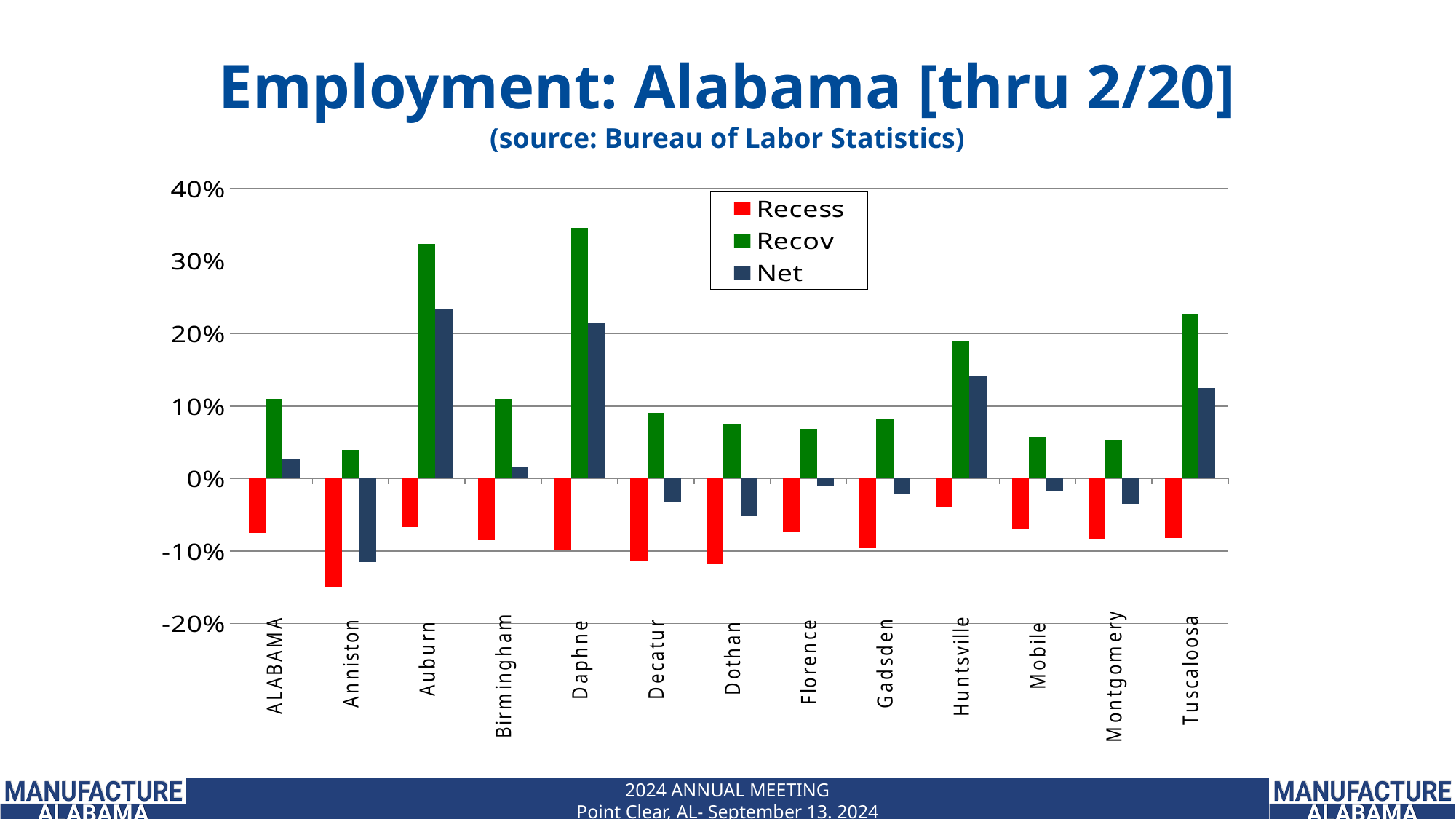
Which category has the lowest Recess value? Anniston Which category has the highest Recov value? Daphne What kind of chart is shown on the slide? bar chart Which category has the highest Net value? Auburn Is the Recov value for Daphne greater or less than 30%? greater Is the Recess value for Anniston greater or less than -10%? less Which is larger, the Recov value for Auburn or the Recov value for Huntsville? Auburn What is the title of the chart? Employment: Alabama [thru 2/20] How many categories are shown on the x axis? 13 How many series does the legend list? 3 Is the Recov value for Tuscaloosa greater or less than 20%? greater Which category has the lowest Net value? Anniston